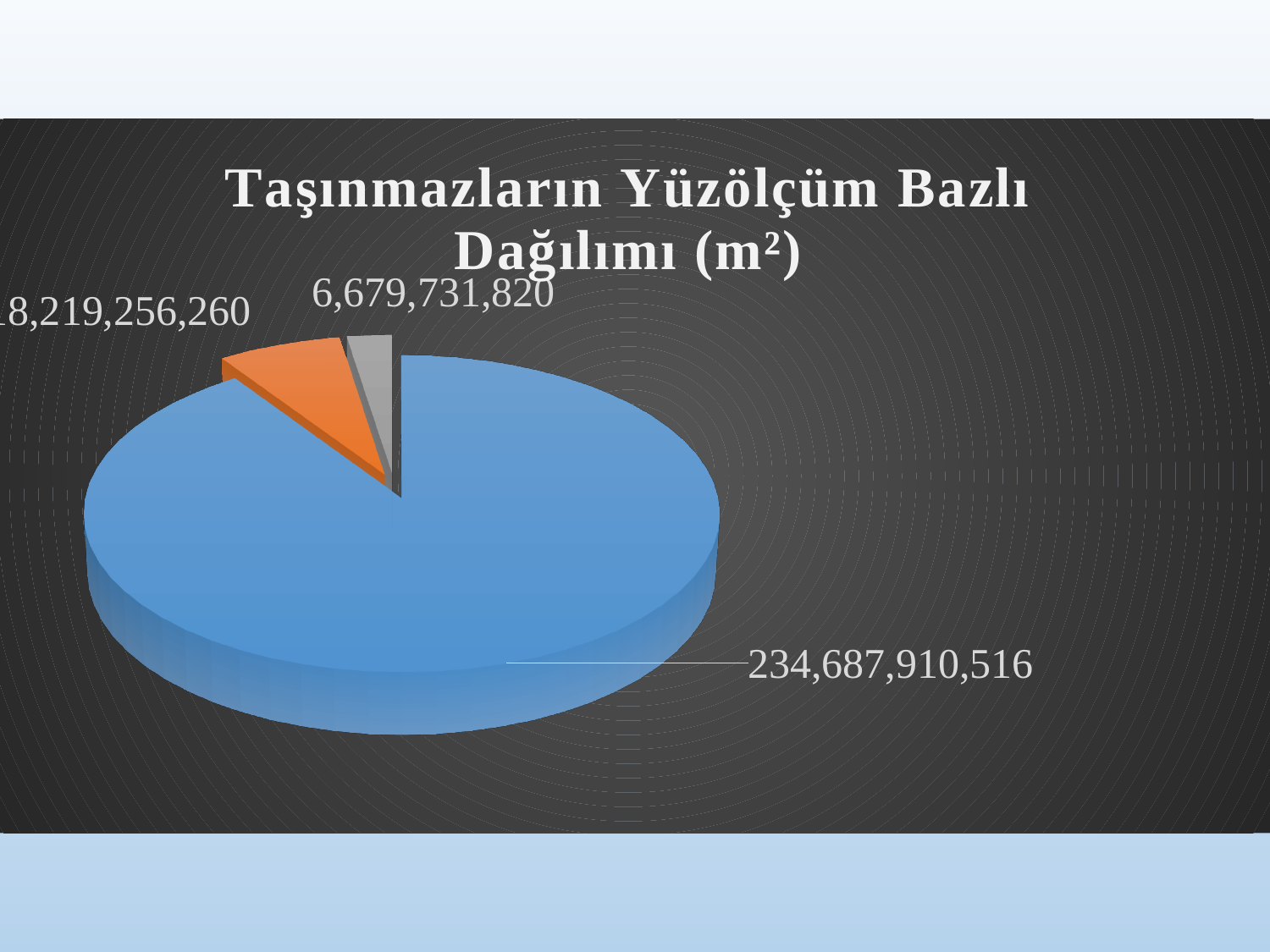
What value is labelled on the blue slice of the pie chart? 234,687,910,516 How many slices does the pie chart have? 3 Which slice of the pie chart is the largest? the blue slice (234,687,910,516) What is the title of the chart? Taşınmazların Yüzölçüm Bazlı Dağılımı (m²) Which is larger, the orange slice or the grey slice? the orange slice What is the difference between the blue slice value (234,687,910,516) and the grey slice value (6,679,731,820)? 228,008,178,696 What kind of chart is shown on the slide? pie chart Which is larger, the blue slice or the grey slice? the blue slice What colour is the largest slice of the pie chart? blue Which slice of the pie chart is the smallest? the grey slice (6,679,731,820) What value is labelled on the grey slice of the pie chart? 6,679,731,820